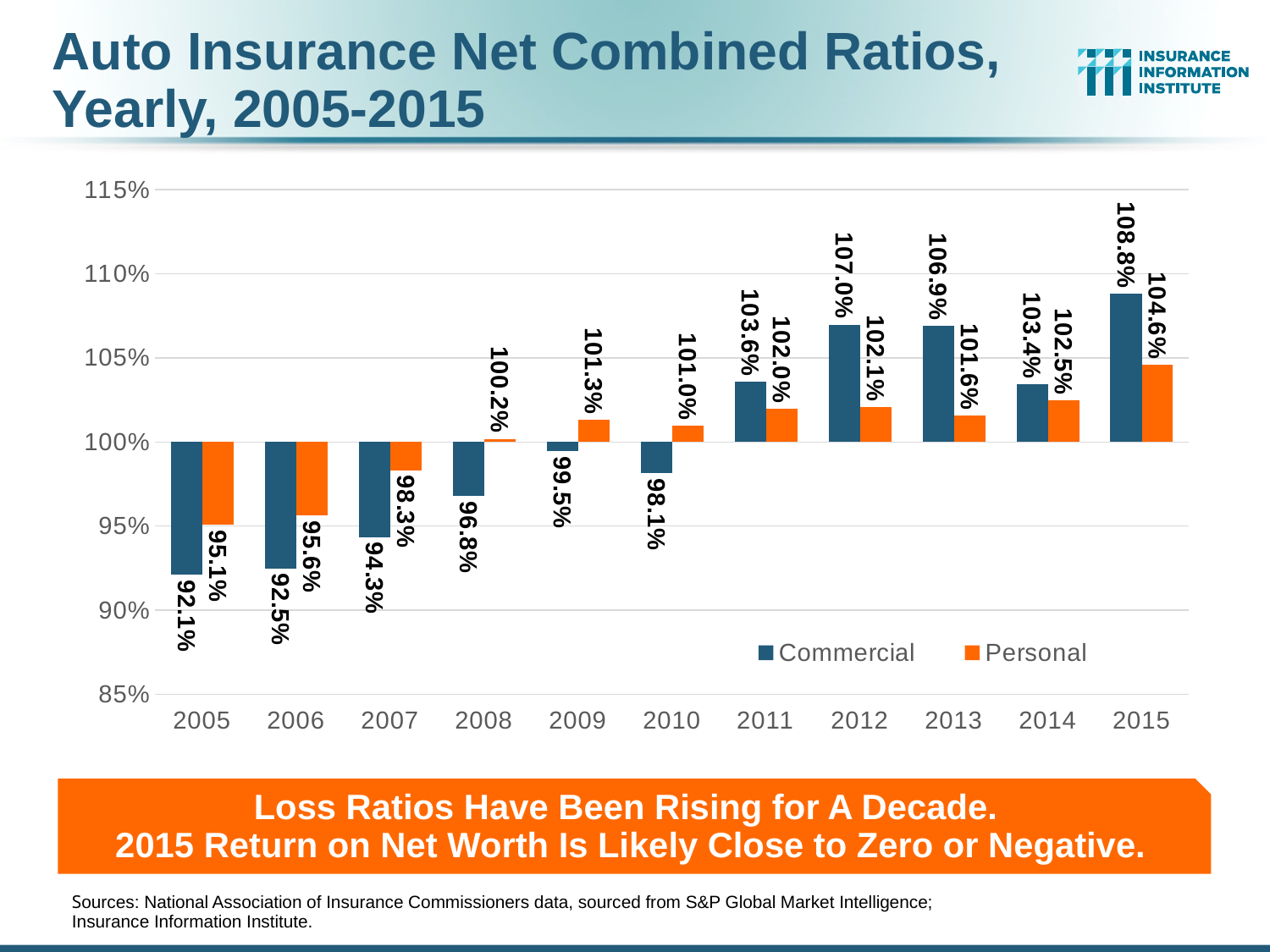
Which year has the lowest Personal net combined ratio? 2005 How many years are shown on the x axis? 11 How many series does the legend list? 2 What is the Commercial net combined ratio for 2010? 98.1% Which colour represents the Personal series in the chart? Orange What is the Commercial net combined ratio for 2015? 108.8% What is the difference between the Commercial and Personal ratios in 2012? 4.9% Which year has the highest Commercial net combined ratio? 2015 What is the Personal net combined ratio for 2008? 100.2% What kind of chart is shown on the slide? Bar chart In 2013, which is larger, the Commercial or the Personal net combined ratio? Commercial In 2007, which is larger, the Commercial or the Personal net combined ratio? Personal